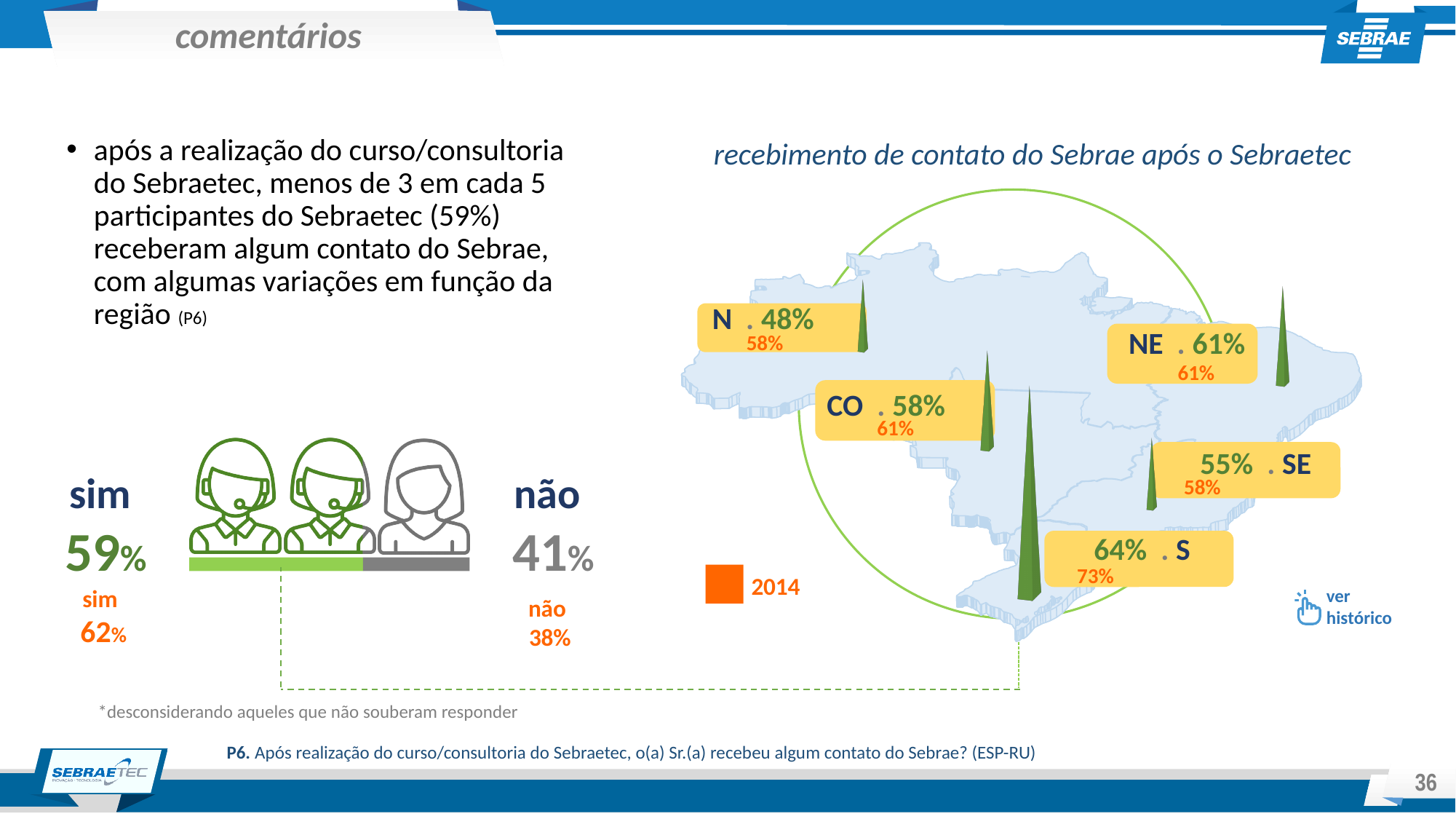
In the map chart 'recebimento de contato do Sebrae após o Sebraetec', what is the difference between the current values for NE and N? 13 percentage points In the map chart 'recebimento de contato do Sebrae após o Sebraetec', what is the current value shown for the S region? 64% In the sim/não bar on the left of the slide, what is the 2014 percentage for 'não'? 38% Which year does the orange legend square on the map chart refer to? 2014 In the map chart 'recebimento de contato do Sebrae após o Sebraetec', which region has the highest current value? S In the map chart 'recebimento de contato do Sebrae após o Sebraetec', what is the current value shown for the N region? 48% How many regions are shown in the map chart 'recebimento de contato do Sebrae após o Sebraetec'? 5 In the sim/não bar on the left of the slide, what is the current percentage for 'sim'? 59% In the map chart 'recebimento de contato do Sebrae após o Sebraetec', which region has the larger current value, CO or SE? CO In the map chart 'recebimento de contato do Sebrae após o Sebraetec', what is the 2014 value shown for the CO region? 61% In the map chart 'recebimento de contato do Sebrae após o Sebraetec', which region has the lowest current value? N In the map chart 'recebimento de contato do Sebrae após o Sebraetec', what is the 2014 value shown for the S region? 73%